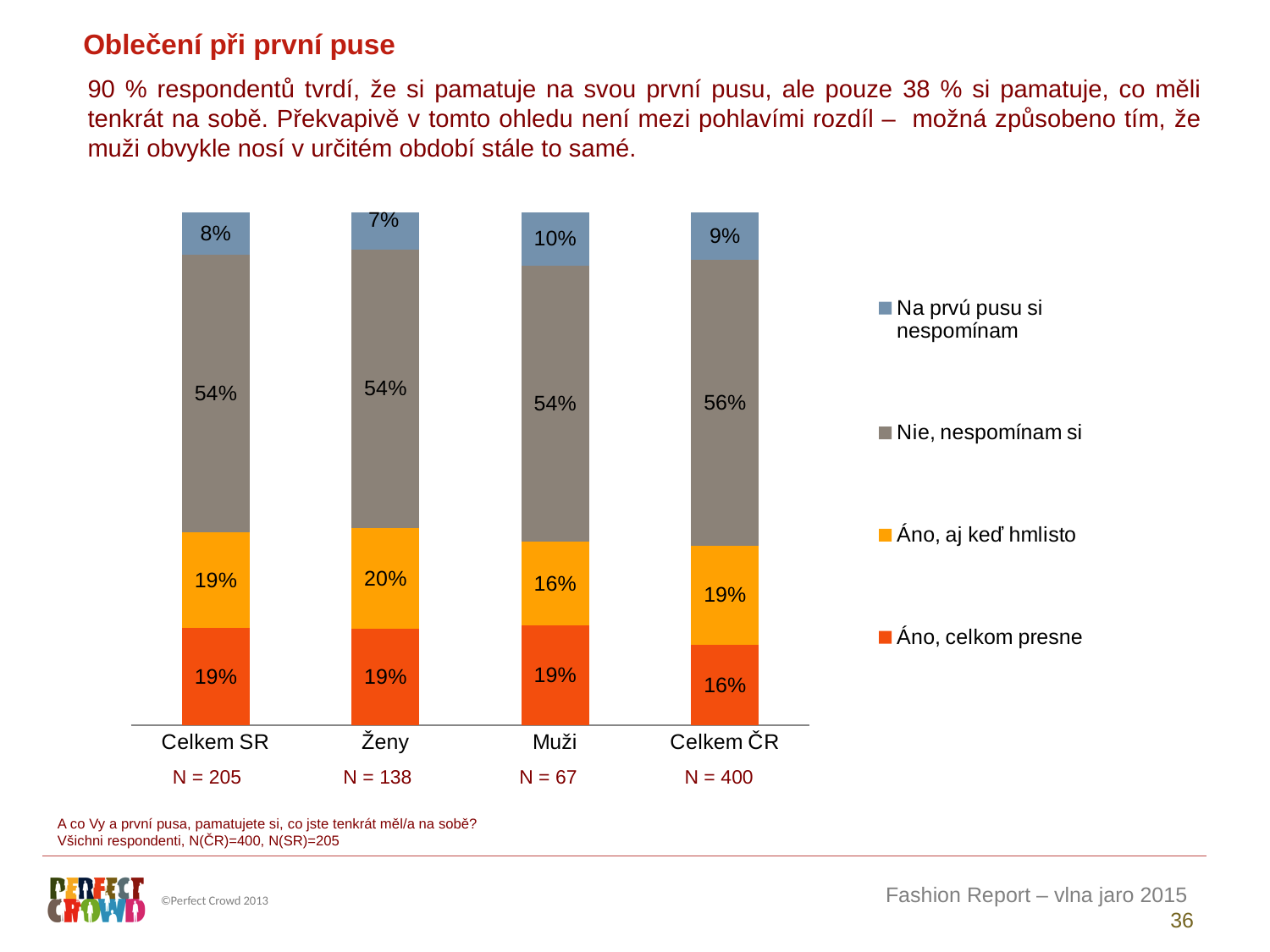
What is the value of 'Áno, aj keď hmlisto' for Ženy? 20% Which is larger: the 'Nie, nespomínam si' value for Celkem ČR or for Celkem SR? Celkem ČR What is the difference between the 'Áno, aj keď hmlisto' values for Ženy and Muži? 4% How many series does the chart legend list? 4 How many categories are shown on the x axis of the chart? 4 Which category has the lowest value for 'Áno, aj keď hmlisto'? Muži Which category has the highest value for 'Na prvú pusu si nespomínam'? Muži What is the value of 'Nie, nespomínam si' for Celkem ČR? 56% What kind of chart is shown on the slide? Stacked bar chart What is the value of 'Áno, celkom presne' for Celkem ČR? 16% What is the value of 'Na prvú pusu si nespomínam' for Muži? 10% What is the sample size (N) shown for Ženy? N = 138